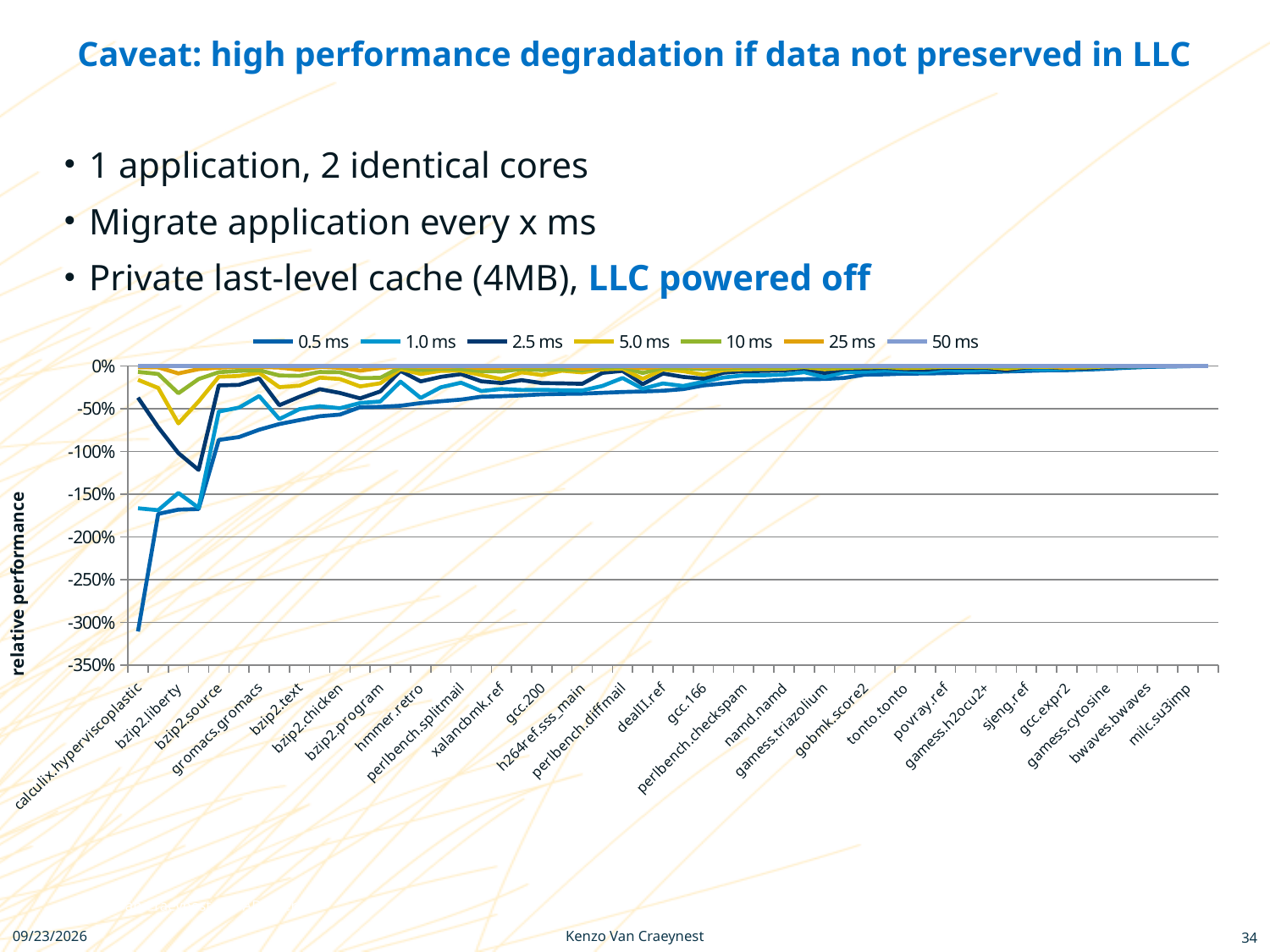
Does the 0.5 ms series generally rise or fall moving left to right along the x axis? rise Is the value for the 0.5 ms series at calculix.hyperviscoplastic greater or less than -250%? less What kind of chart is shown on the slide? line chart At bzip2.liberty, which series has the larger value, 1.0 ms or 5.0 ms? 5.0 ms At calculix.hyperviscoplastic, which series has the larger value, 0.5 ms or 50 ms? 50 ms Which category has the lowest value for the 0.5 ms series? calculix.hyperviscoplastic How many series does the chart's legend list? 7 Which series has the lowest value at calculix.hyperviscoplastic? 0.5 ms What is the first entry in the chart's legend? 0.5 ms What is the label on the chart's vertical axis? relative performance Is the value for the 2.5 ms series at bzip2.liberty greater or less than -50%? less Is the value for the 0.5 ms series at milc.su3imp greater or less than -50%? greater